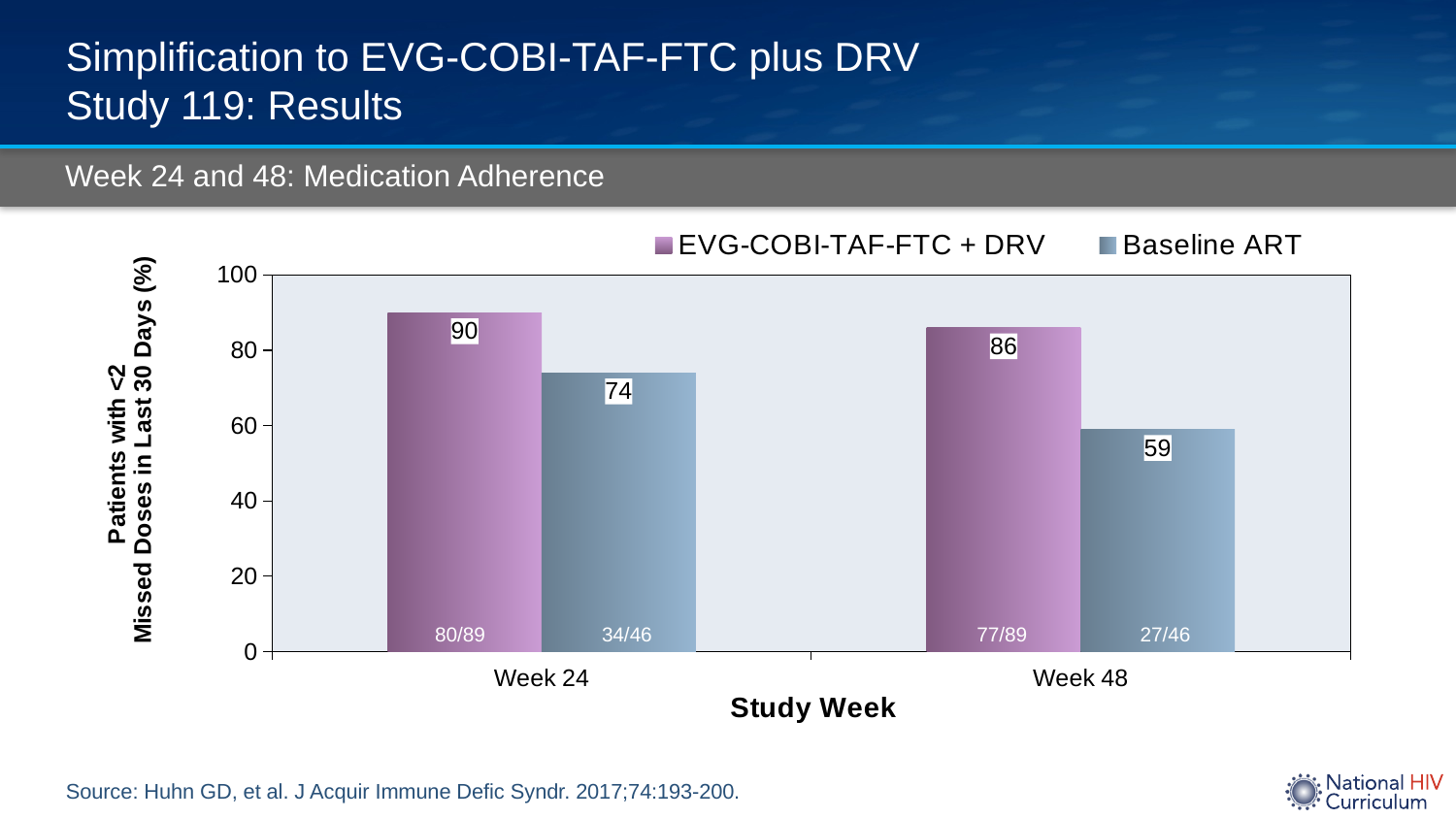
Does the Baseline ART value rise or fall from Week 24 to Week 48? Fall What is the value for EVG-COBI-TAF-FTC + DRV at Week 24? 90 How many series does the legend list? 2 What kind of chart is shown on the slide? Bar chart Which series has the highest value at Week 48? EVG-COBI-TAF-FTC + DRV What is the value for Baseline ART at Week 24? 74 How many study week categories are shown on the x axis? 2 What is the value for Baseline ART at Week 48? 59 What is the value for EVG-COBI-TAF-FTC + DRV at Week 48? 86 What is the difference between the EVG-COBI-TAF-FTC + DRV and Baseline ART values at Week 24? 16 Which is larger: Baseline ART at Week 24 or Baseline ART at Week 48? Baseline ART at Week 24 Which bar has the lowest value on the chart? Baseline ART at Week 48